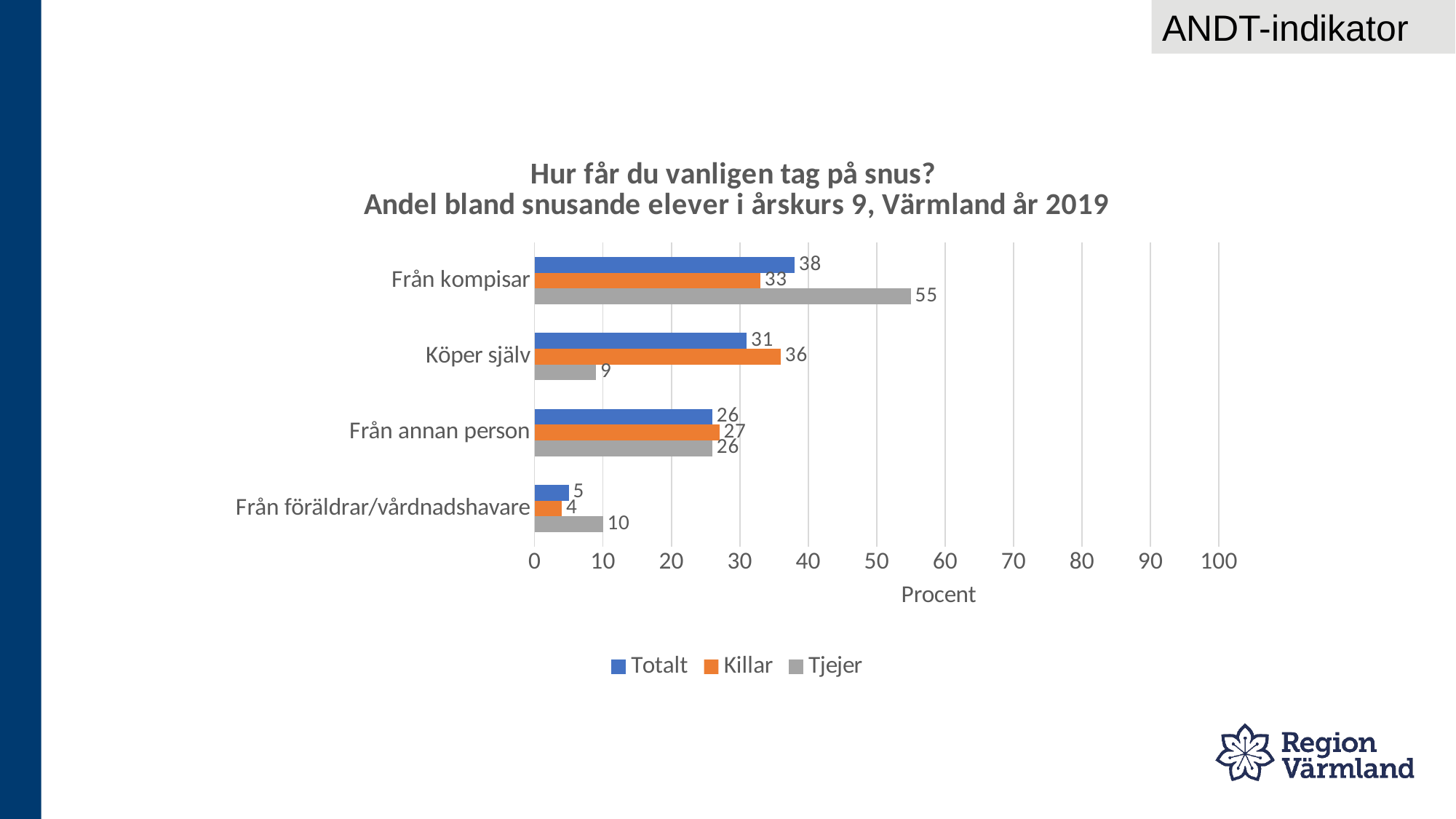
Which category has the highest Totalt value? Från kompisar For Köper själv, which is larger: the Killar value or the Tjejer value? Killar What is the difference between the Tjejer and Killar values for Från kompisar? 22 Which category has the lowest Killar value? Från föräldrar/vårdnadshavare What is the Totalt value for Från annan person? 26 What is the label of the x axis? Procent What is the Tjejer value for Från kompisar? 55 What is the Killar value for Köper själv? 36 How many series does the legend list? 3 What is the Tjejer value for Från föräldrar/vårdnadshavare? 10 How many categories are shown on the y axis? 4 What kind of chart is shown on the slide? Bar chart